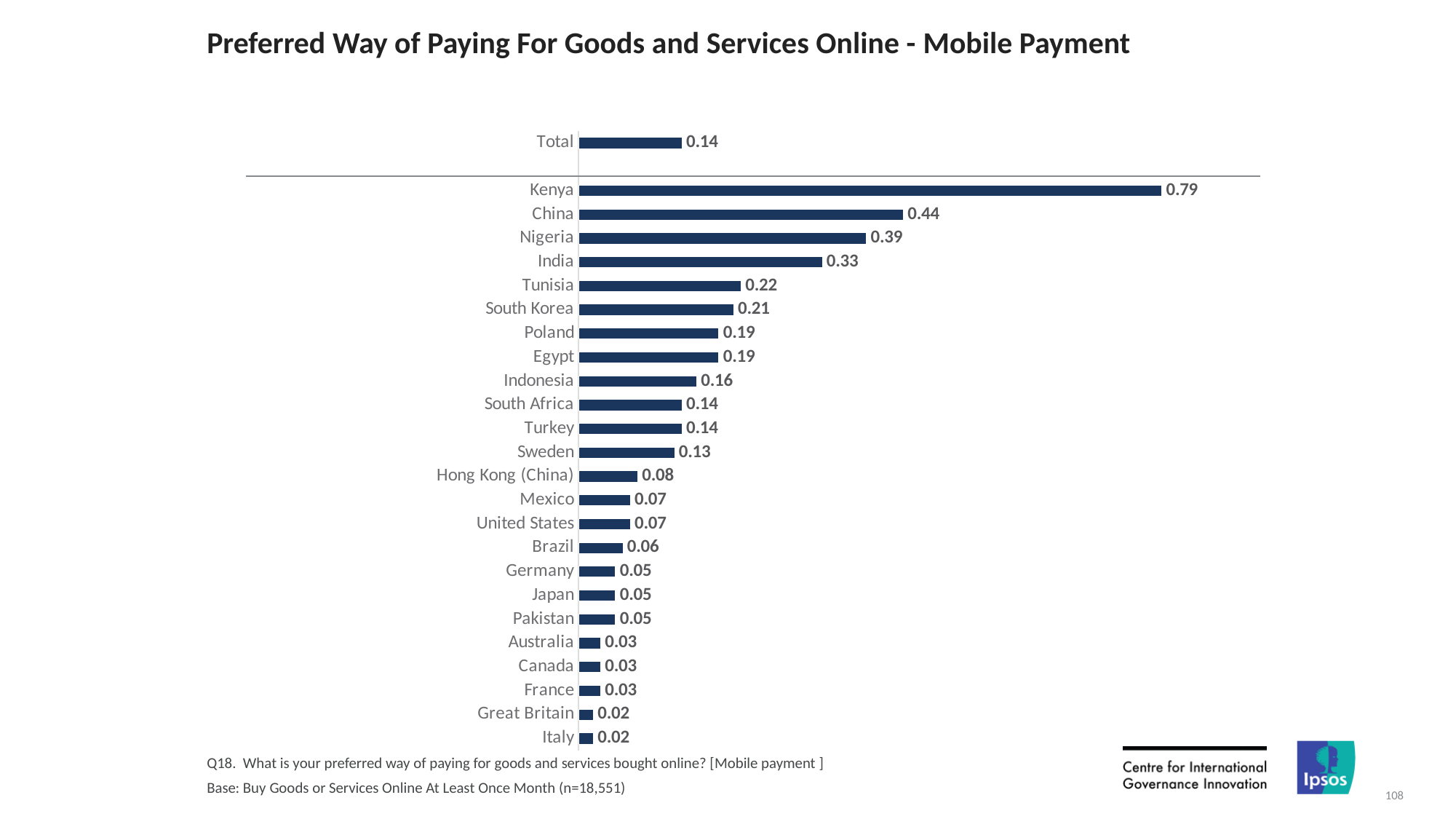
What is the value for the Total bar? 0.14 What is the value for India? 0.33 What is the value for Sweden? 0.13 What is the value for Kenya? 0.79 Which country has the highest value? Kenya What kind of chart is shown on the slide? Bar chart What is the difference between the values for China and Nigeria? 0.05 What is the title of the chart? Preferred Way of Paying For Goods and Services Online - Mobile Payment How many countries are listed below the Total bar? 24 Which has a larger value, Hong Kong (China) or Brazil? Hong Kong (China) What is the difference between the values for Kenya and India? 0.46 Which has a larger value, Tunisia or Indonesia? Tunisia